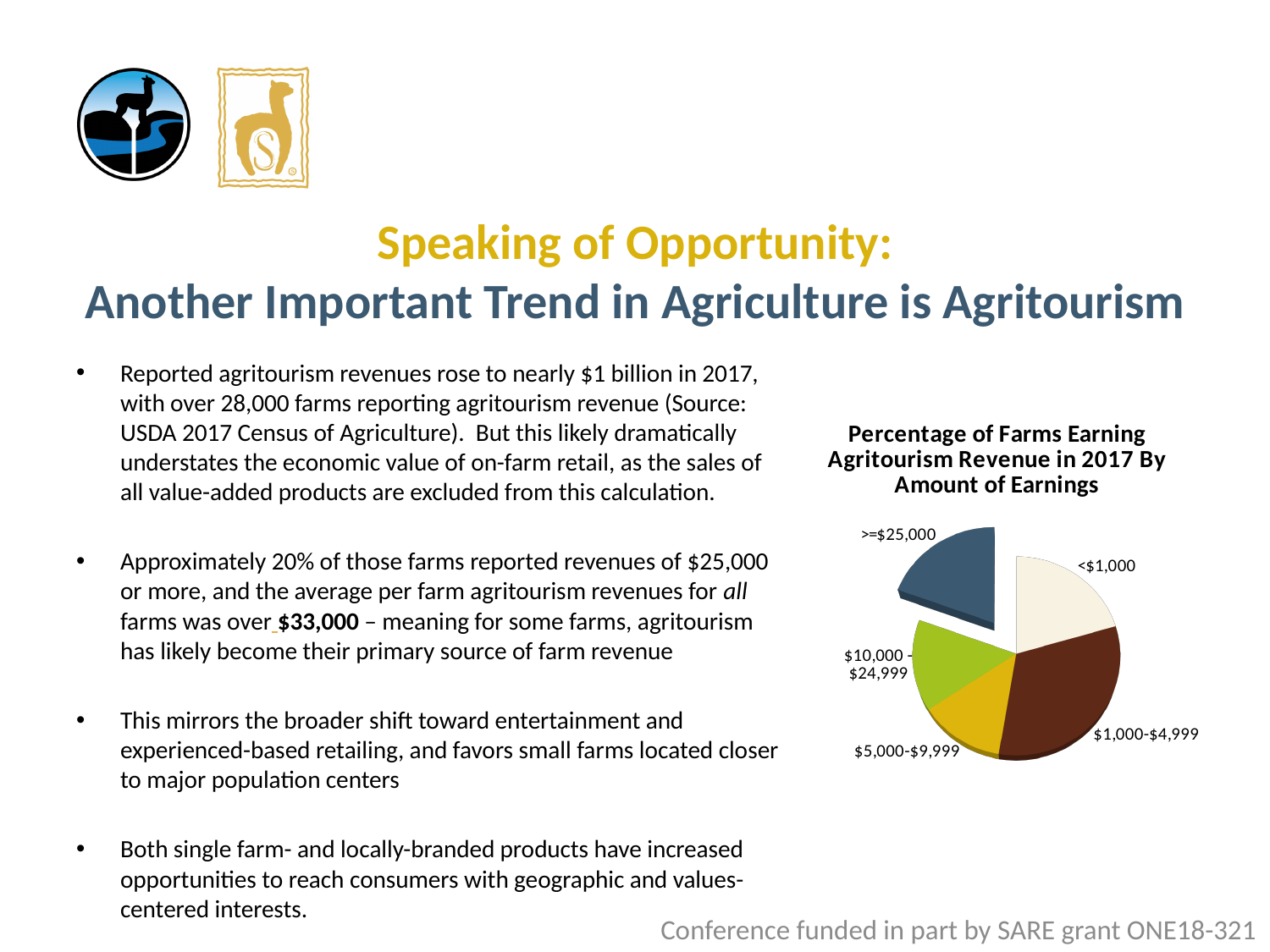
Which earnings category has the largest slice of the pie chart? $1,000-$4,999 Which slice is larger: >=$25,000 or $5,000-$9,999? >=$25,000 Which slice of the pie chart is pulled out (exploded) from the rest of the pie? >=$25,000 How many earnings categories (slices) does the pie chart show? 5 What kind of chart is shown on the slide? pie chart Which slice is larger: <$1,000 or $10,000-$24,999? <$1,000 Which slice is larger: $1,000-$4,999 or $5,000-$9,999? $1,000-$4,999 What is the title of the pie chart? Percentage of Farms Earning Agritourism Revenue in 2017 By Amount of Earnings